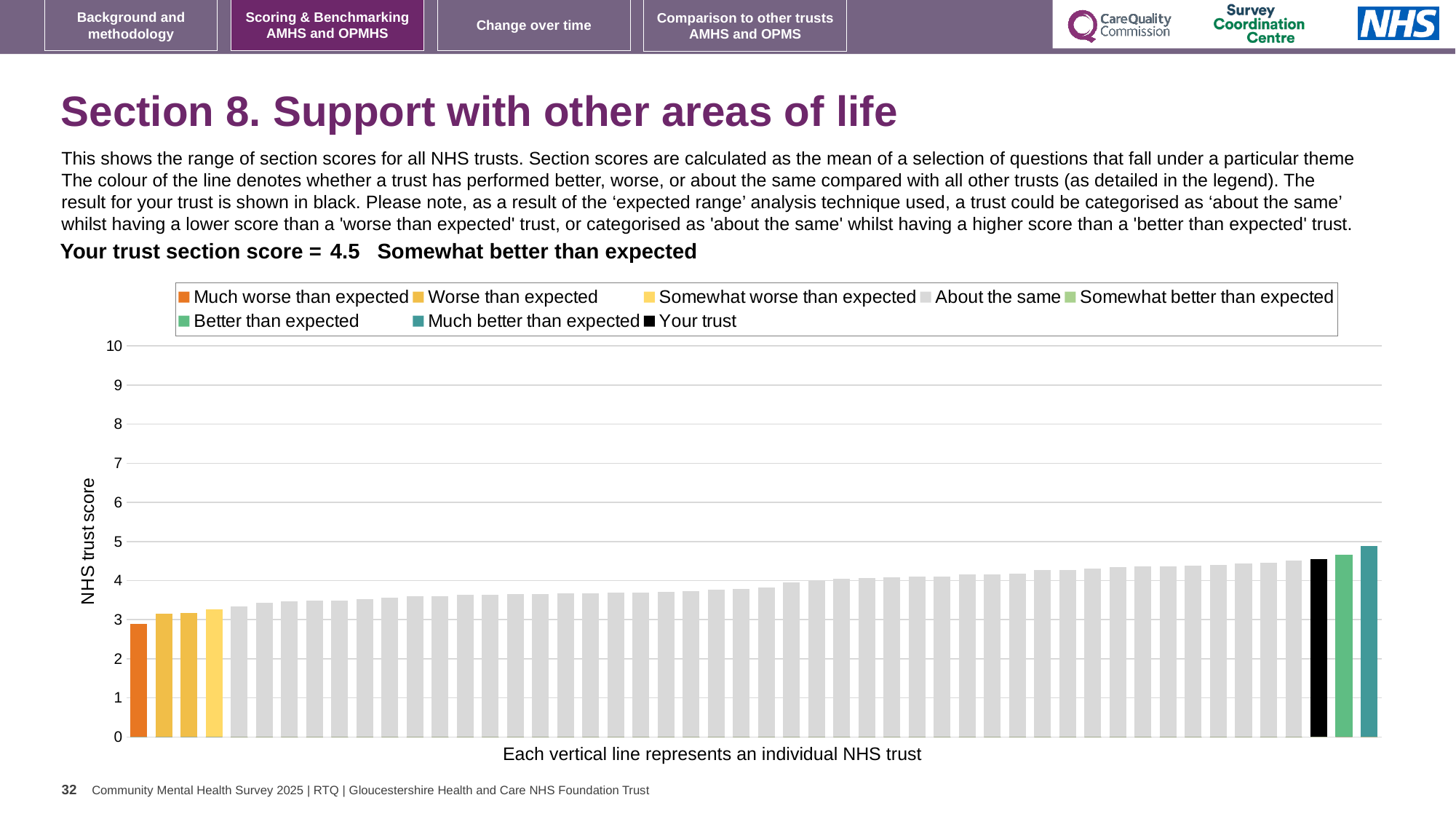
What is the section score for your trust? 4.5 Do the bar values rise or fall from left to right along the x axis? rise How many entries does the chart legend list? 8 Is the value of the leftmost (orange) bar greater or less than 4? less Which legend category does the shortest bar belong to? Much worse than expected Is the value of the tallest bar greater or less than 4? greater What kind of chart is shown on the slide? bar chart Which legend category does the tallest bar belong to? Much better than expected Which is larger, the black 'Your trust' bar or the orange 'Much worse than expected' bar? the black 'Your trust' bar Is the value of the black 'Your trust' bar greater or less than 4? greater Which legend category does your trust fall into according to the text above the chart? Somewhat better than expected What is the label on the y axis of the chart? NHS trust score